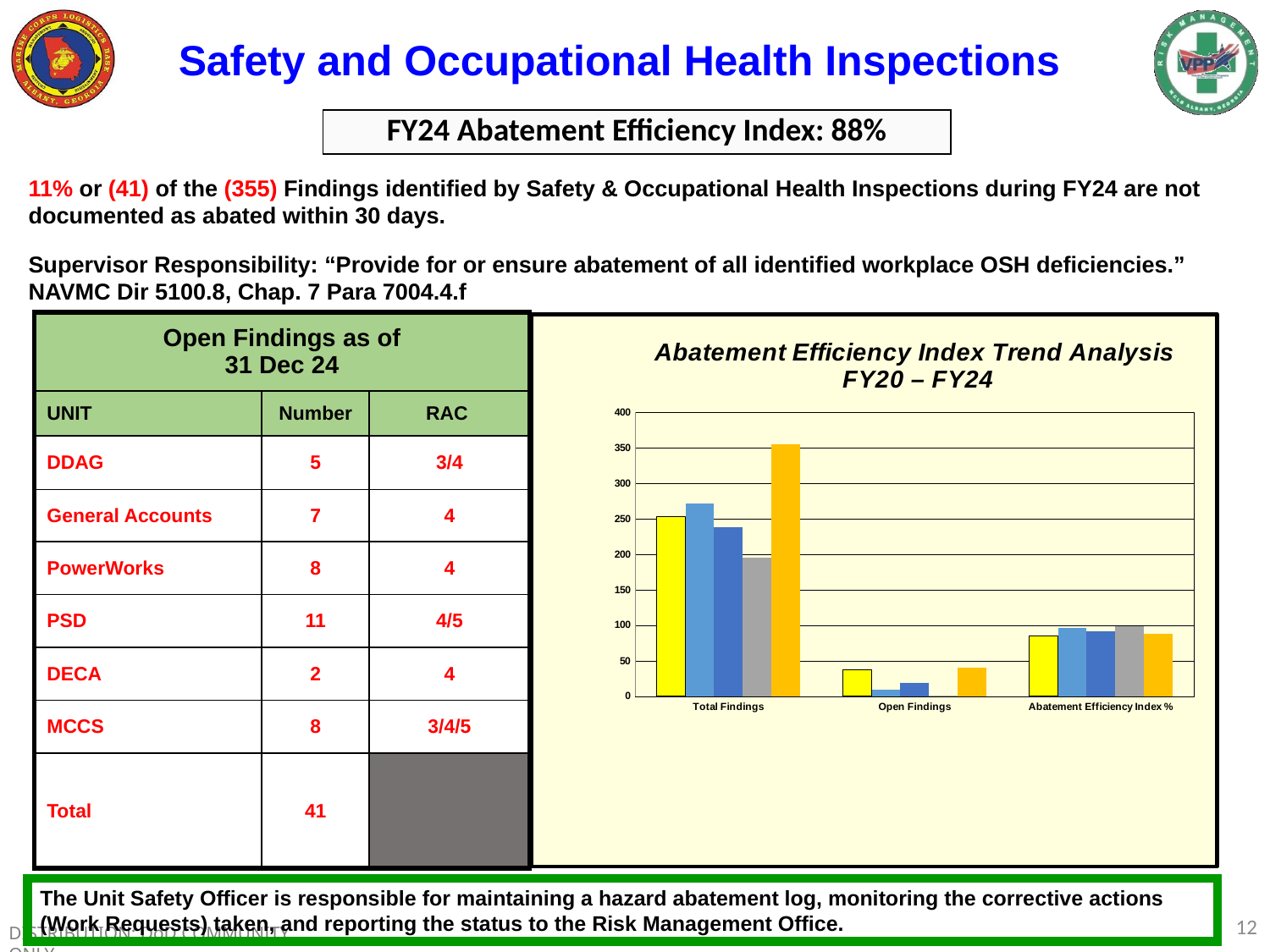
Is the gray bar in the Abatement Efficiency Index % category greater or less than 50? greater Which category in the chart has the shortest bars overall? Open Findings Is the yellow bar in the Total Findings category greater or less than 200? greater Is the tallest bar in the Open Findings category greater or less than 50? less What is the title of the chart on the slide? Abatement Efficiency Index Trend Analysis FY20 – FY24 How many bars are plotted for each category in the chart? 5 In the Total Findings category, which is larger: the orange bar or the yellow bar? the orange bar How many categories are shown on the x axis of the chart? 3 What type of chart is shown on the slide? bar chart Which category in the chart contains the tallest bar? Total Findings